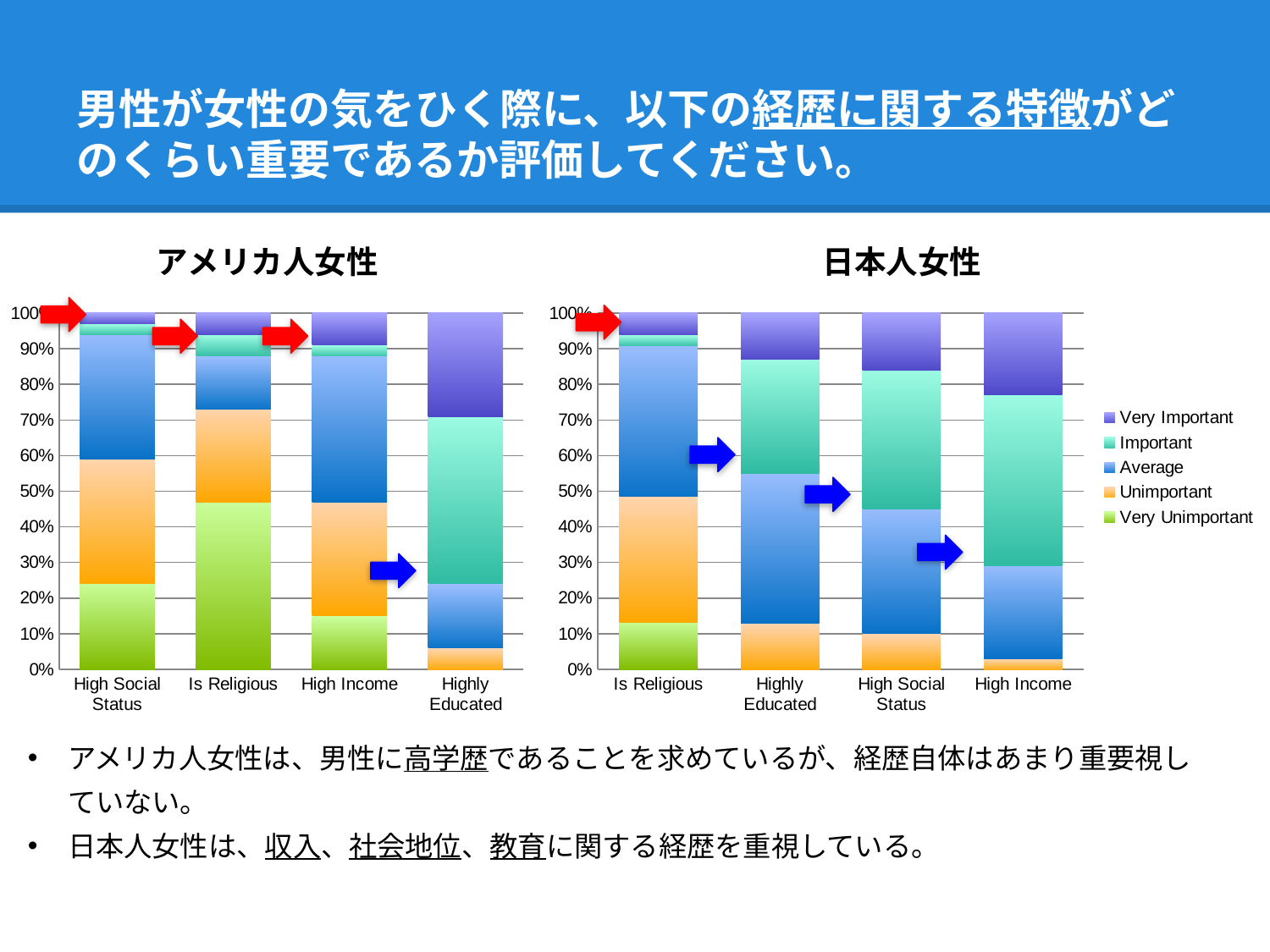
What kind of chart is the アメリカ人女性 chart? Stacked bar chart In the 日本人女性 chart, is the Very Unimportant value for High Income greater or less than 10%? less In the アメリカ人女性 chart, is the Very Unimportant value for Is Religious greater or less than 40%? greater In the アメリカ人女性 chart, which category has the largest Very Unimportant segment? Is Religious In the 日本人女性 chart, is the Very Important segment for High Income larger or smaller than 20%? larger Which legend entry is shown in purple on the charts? Very Important In the アメリカ人女性 chart, is the Very Unimportant segment larger for Is Religious or for High Social Status? Is Religious How many categories are shown on the x axis of the 日本人女性 chart? 4 In the 日本人女性 chart, which category has the largest Very Important segment? High Income In the アメリカ人女性 chart, which category has the smallest Very Unimportant segment? Highly Educated How many series does the legend list for the charts? 5